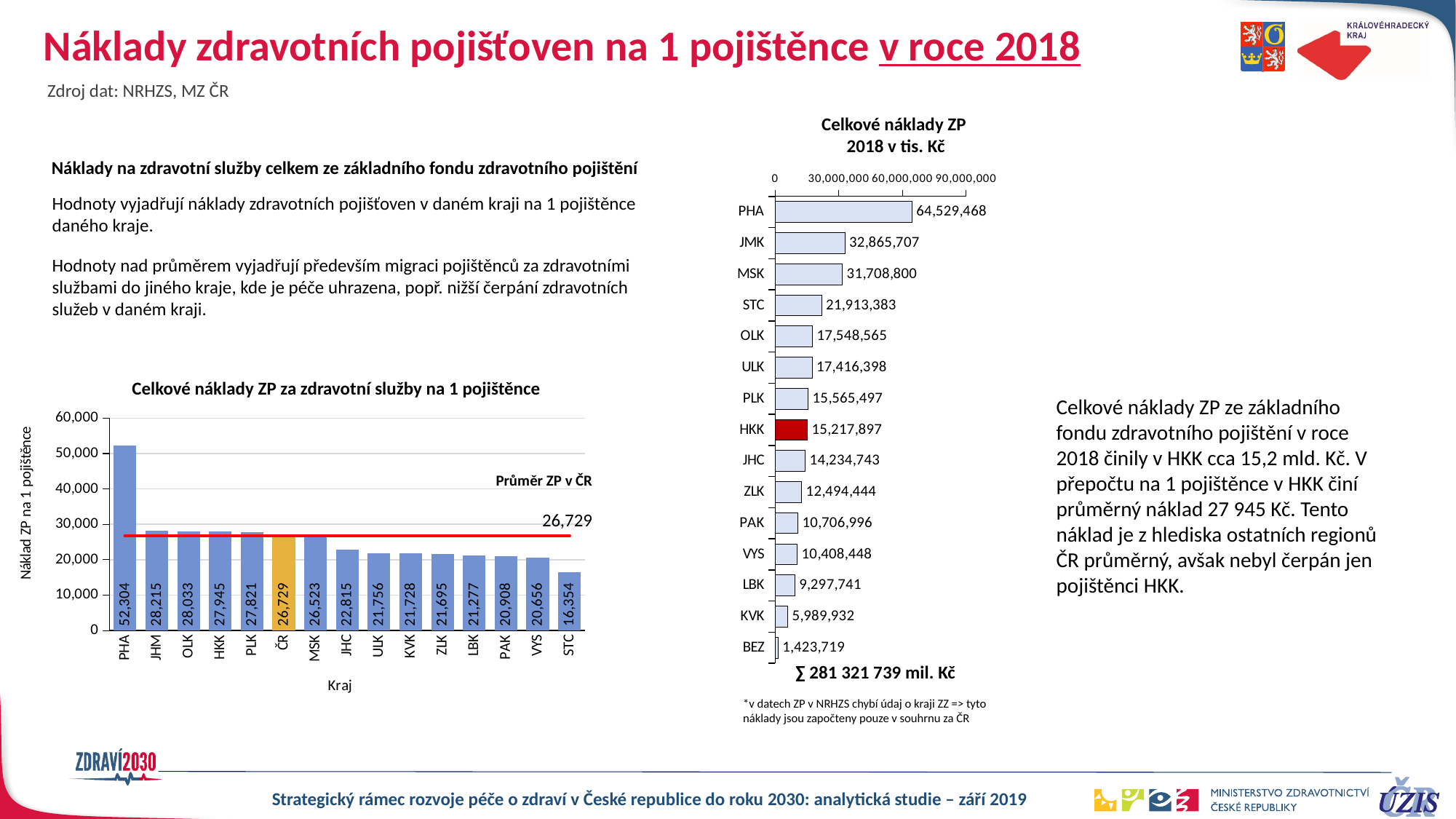
In the chart 'Celkové náklady ZP za zdravotní služby na 1 pojištěnce', what is the value of the ČR average shown by the red line? 26,729 In the chart 'Celkové náklady ZP za zdravotní služby na 1 pojištěnce', which bar is coloured orange? ČR In the chart 'Celkové náklady ZP 2018 v tis. Kč', which is larger, the value for JMK or the value for MSK? JMK In the chart 'Celkové náklady ZP 2018 v tis. Kč', what is the value for HKK? 15,217,897 In the chart 'Celkové náklady ZP za zdravotní služby na 1 pojištěnce', which region has the highest value? PHA In the chart 'Celkové náklady ZP 2018 v tis. Kč', what is the difference between the values for PHA and JMK? 31,663,761 In the chart 'Celkové náklady ZP za zdravotní služby na 1 pojištěnce', which region has the lowest value? STC In the chart 'Celkové náklady ZP za zdravotní služby na 1 pojištěnce', how many bars are plotted? 15 In the chart 'Celkové náklady ZP 2018 v tis. Kč', which region has the lowest value? BEZ What kind of chart is 'Celkové náklady ZP 2018 v tis. Kč'? Bar chart In the chart 'Celkové náklady ZP za zdravotní služby na 1 pojištěnce', what is the value for HKK? 27,945 In the chart 'Celkové náklady ZP za zdravotní služby na 1 pojištěnce', what is the difference between the values for PHA and STC? 35,950